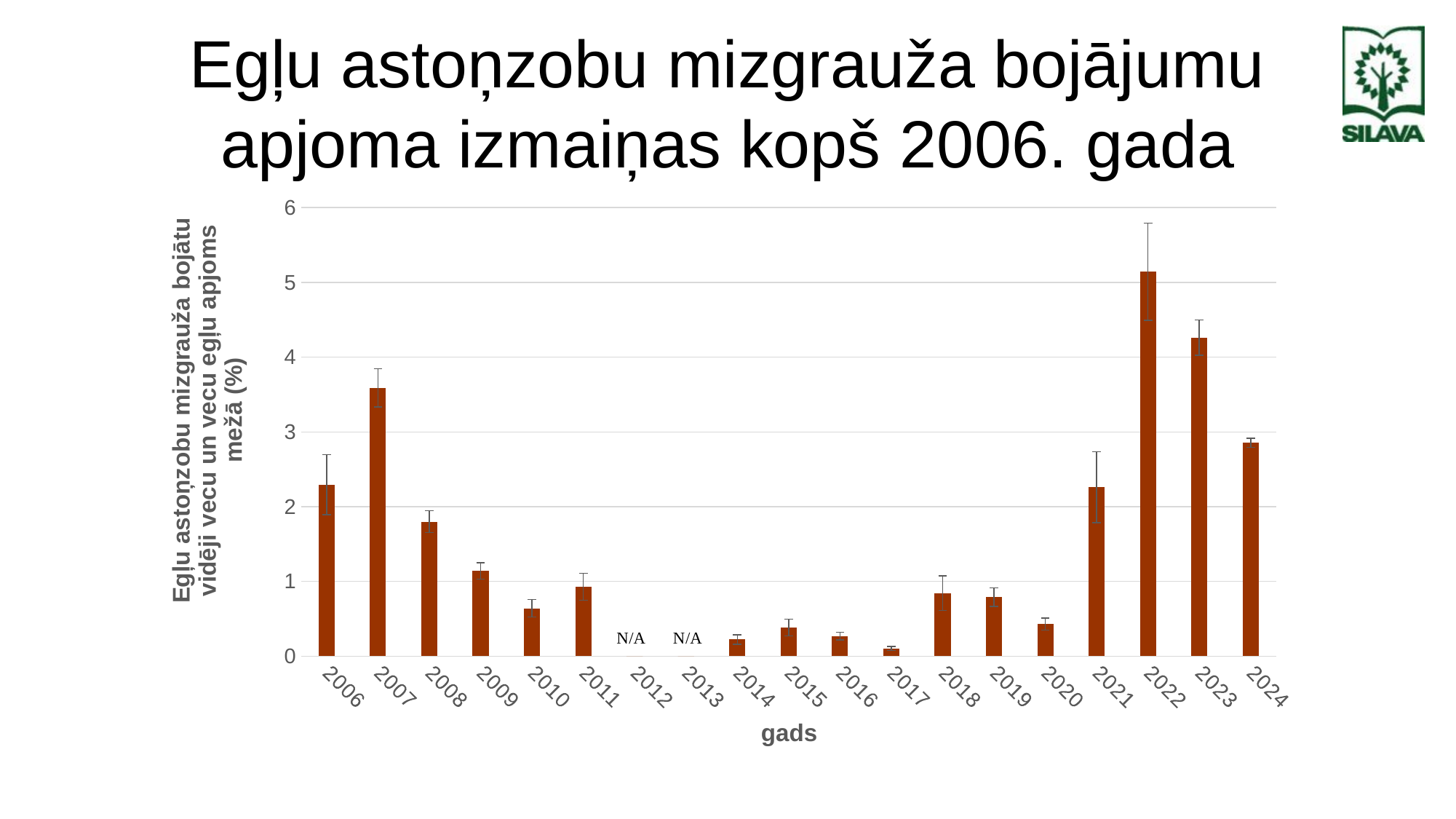
Is the value for 2024 greater or less than 3? less Is the value for 2010 greater or less than 1? less Which year has the larger value, 2009 or 2011? 2009 Which years are marked N/A in the chart? 2012 and 2013 Is the value for 2007 greater or less than 3? greater How many years are listed along the x axis of the chart? 19 Among the years with a plotted bar, which year has the lowest value? 2017 Which year has the highest bar in the chart? 2022 Do the values rise or fall from 2020 to 2022? rise What kind of chart is shown on the slide? bar chart Which year has the larger value, 2022 or 2023? 2022